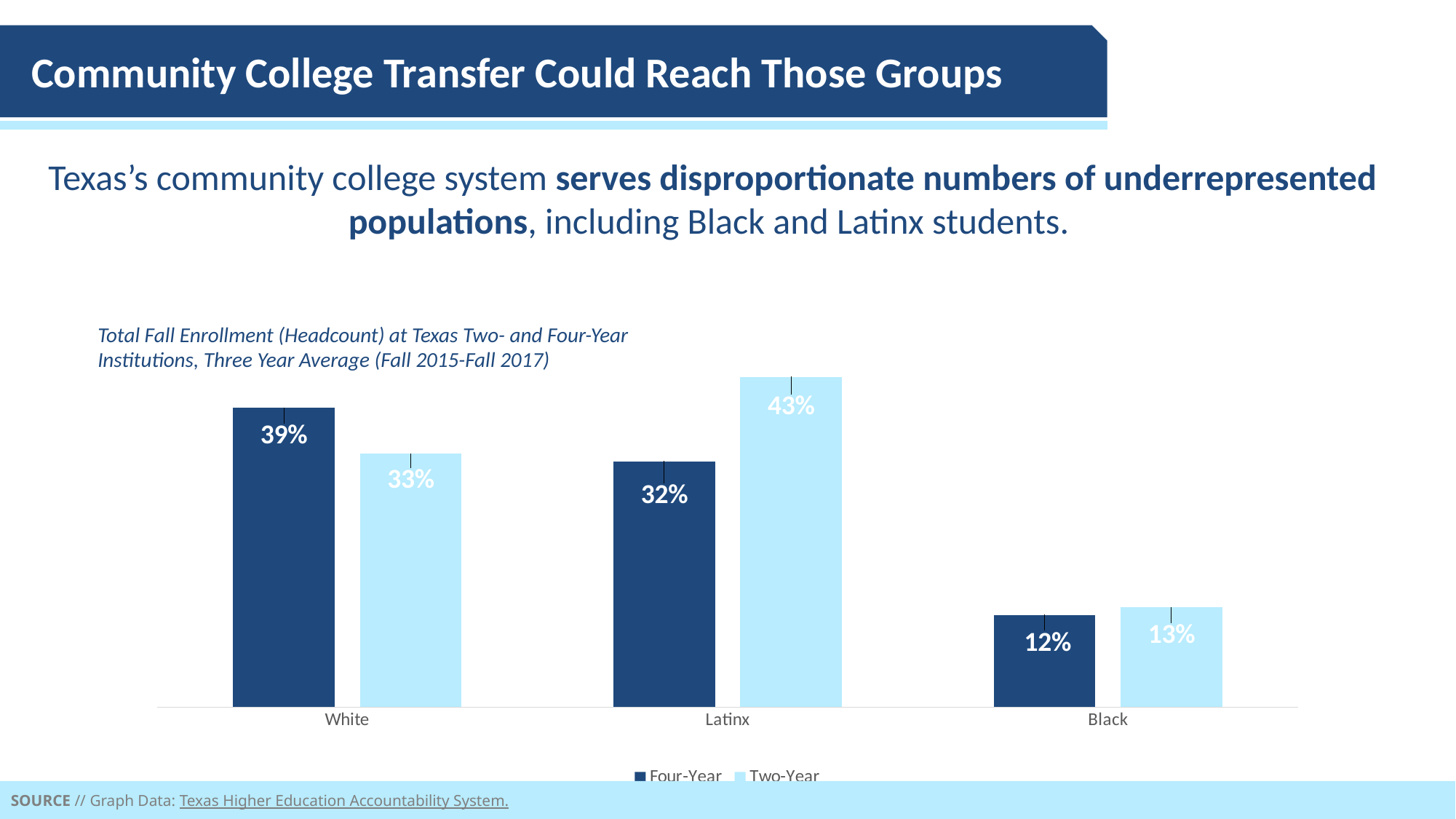
What is the difference between the Two-Year and Four-Year values for Latinx? 11% What kind of chart is shown on the slide? Bar chart How many series does the legend list? 2 What is the Two-Year value for Black? 13% What is the Two-Year value for Latinx? 43% Which category has the highest Two-Year value? Latinx Which category has the lowest Four-Year value? Black Which is larger for White: the Four-Year value or the Two-Year value? Four-Year What is the difference between the Four-Year and Two-Year values for White? 6% How many categories are shown on the x axis? 3 What is the Four-Year value for Latinx? 32% What is the Four-Year value for White? 39%